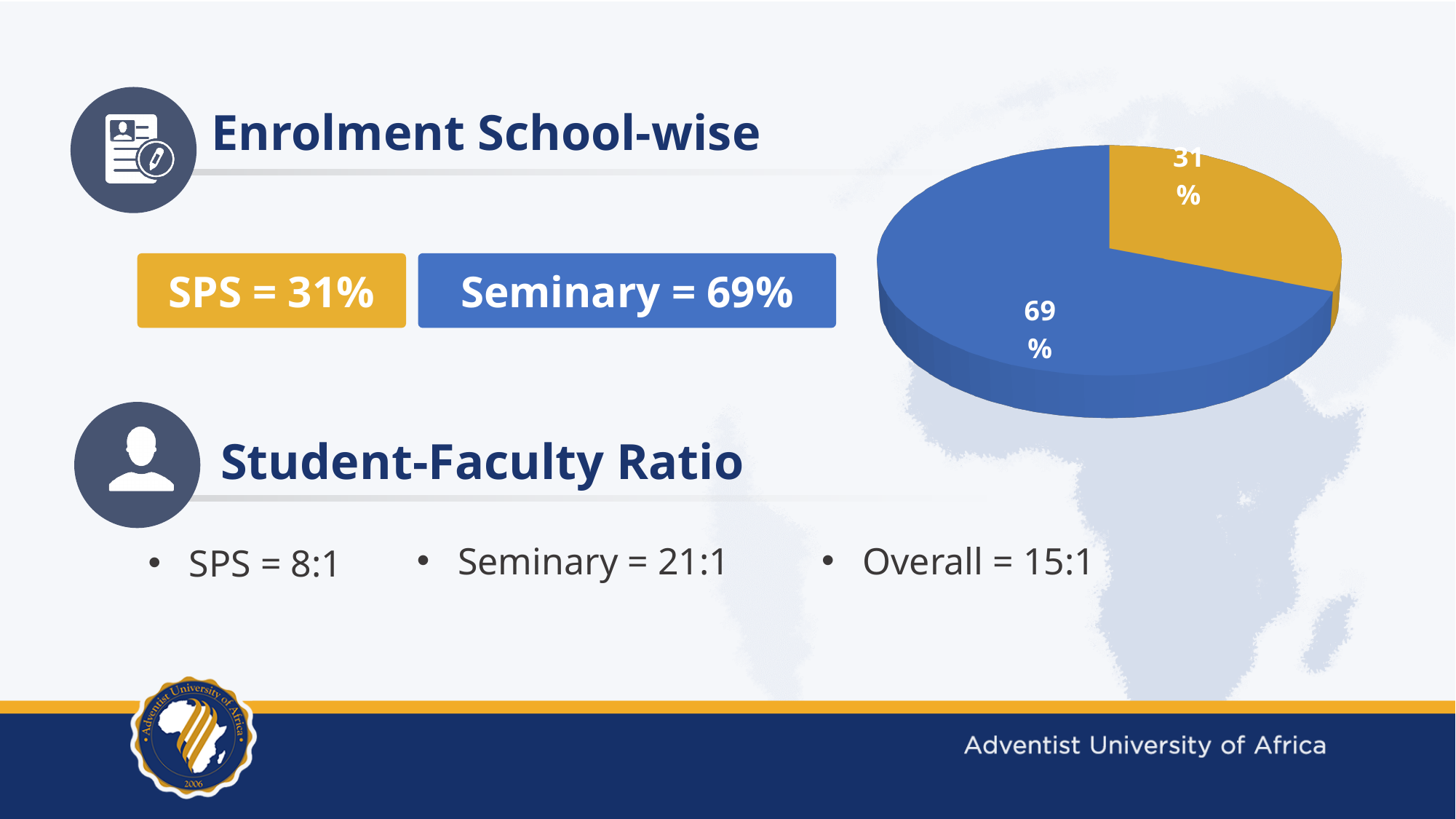
What colour is the SPS slice in the pie chart? Gold What colour is the Seminary slice in the pie chart? Blue Is the SPS share in the pie chart greater or less than 50%? less Is the Seminary share in the pie chart larger or smaller than the SPS share? Larger Which school has the smaller share of enrolment in the pie chart? SPS What is the difference in percentage points between the Seminary and SPS shares in the pie chart? 38 What share of enrolment does the Seminary slice represent in the pie chart? 69% What kind of chart is shown on the slide? Pie chart How many slices does the pie chart have? 2 What share of enrolment does the SPS slice represent in the pie chart? 31% Which school has the larger share of enrolment in the pie chart? Seminary